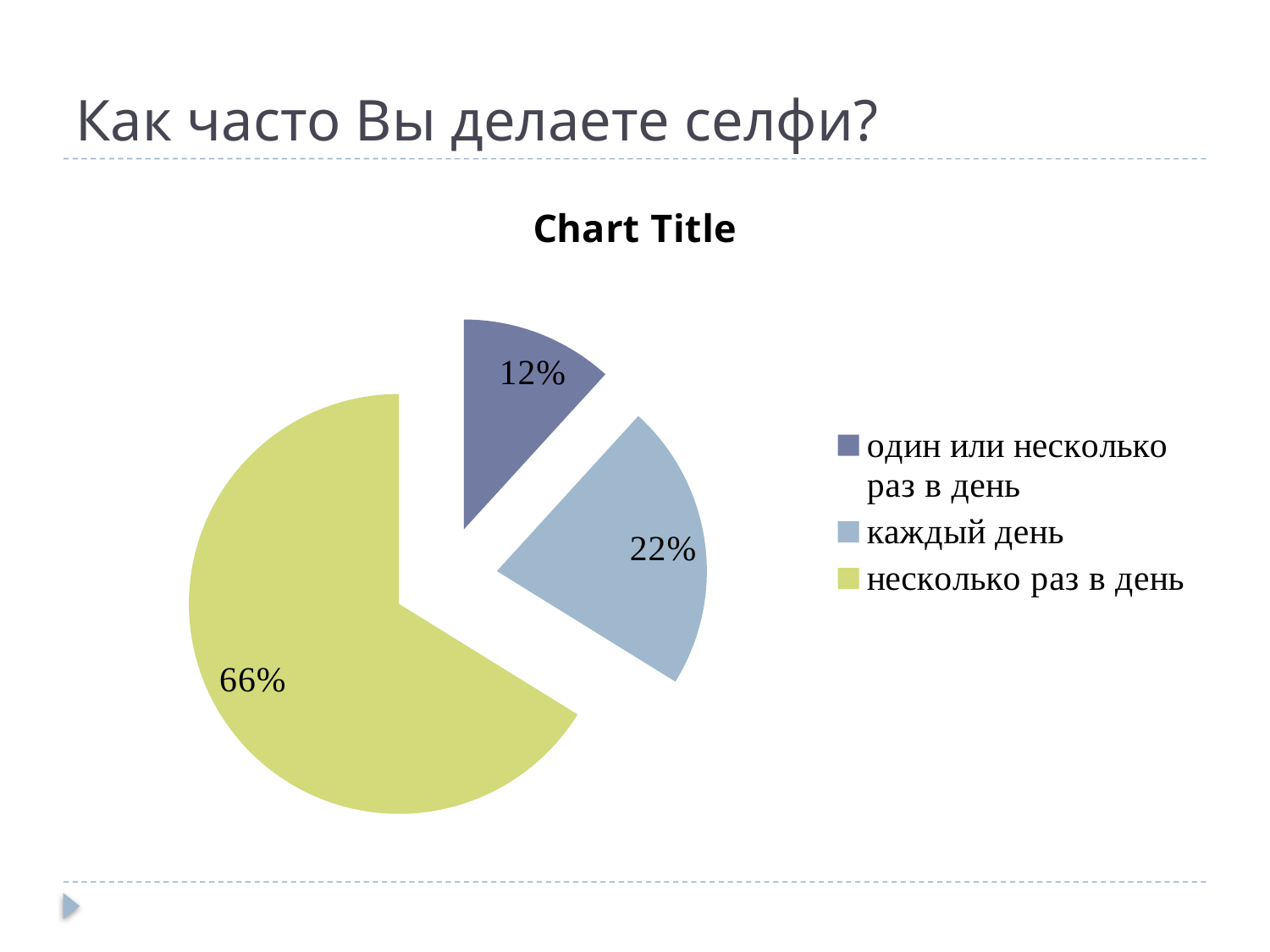
Which category has the smallest slice of the pie? один или несколько раз в день What kind of chart is shown on the slide? pie chart What share of the pie does the slice for "один или несколько раз в день" represent? 12% What is the title printed above the chart? Chart Title Which category has the largest slice of the pie? несколько раз в день What is the difference in percentage points between the "несколько раз в день" slice and the "каждый день" slice? 44 What share of the pie does the slice for "каждый день" represent? 22% What share of the pie does the slice for "несколько раз в день" represent? 66% What colour is the slice for "несколько раз в день"? yellow-green Which slice is larger: "каждый день" or "один или несколько раз в день"? каждый день What is the difference in percentage points between the "каждый день" slice and the "один или несколько раз в день" slice? 10 How many slices does the pie chart have? 3